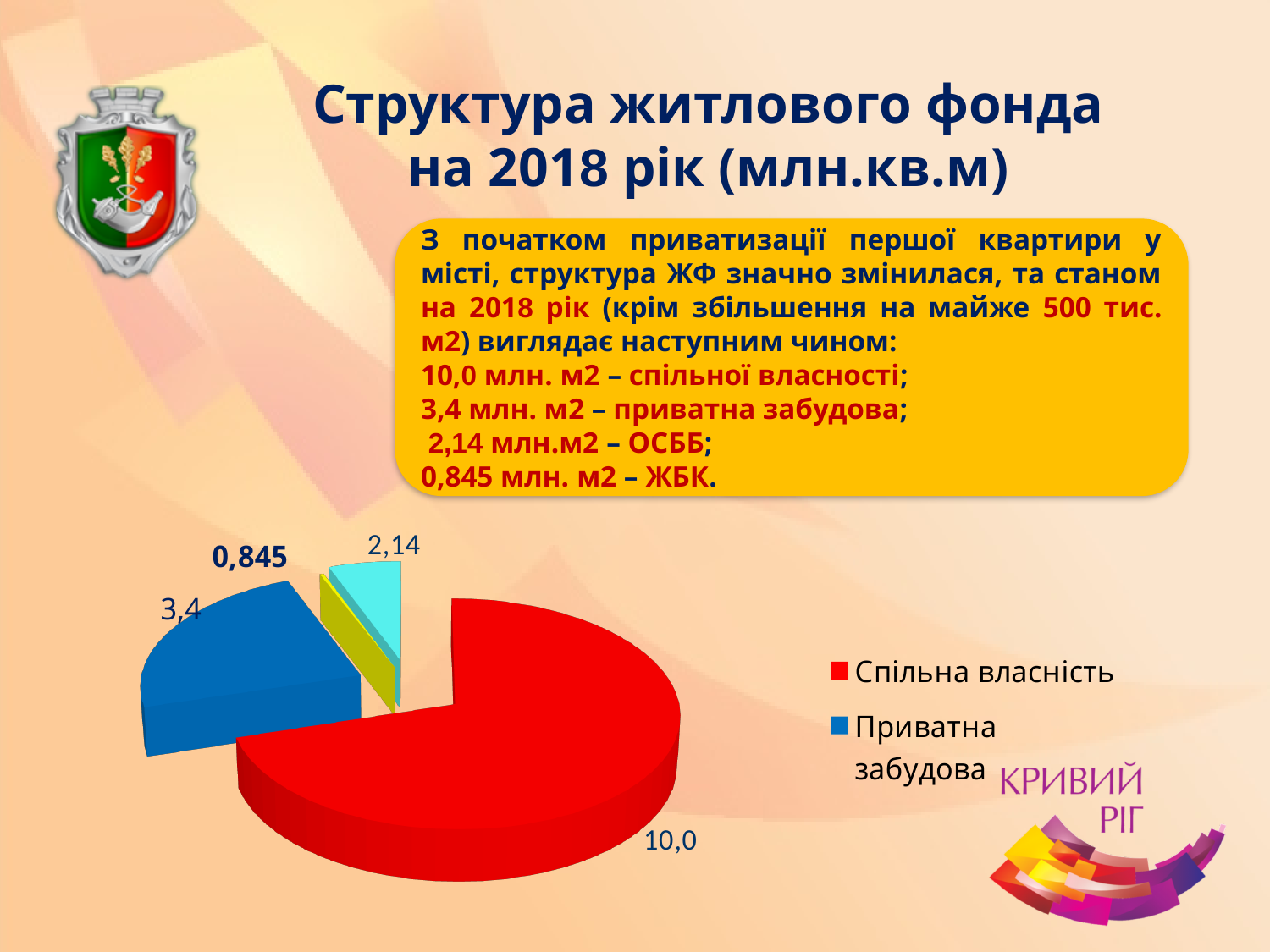
What value is shown for Спільна власність? 10,0 Which category has the largest slice of the pie? Спільна власність What is the smallest value labelled on the pie chart? 0,845 Which is larger, the slice for Спільна власність or the slice for Приватна забудова? Спільна власність What value is shown for Приватна забудова? 3,4 How many slices does the pie chart have? 4 What is the total of all the values labelled on the pie chart? 16,385 What kind of chart is shown on the slide? pie chart What colour is the slice for Приватна забудова? blue What colour is the slice for Спільна власність? red What is the difference between the values for Спільна власність and Приватна забудова? 6,6